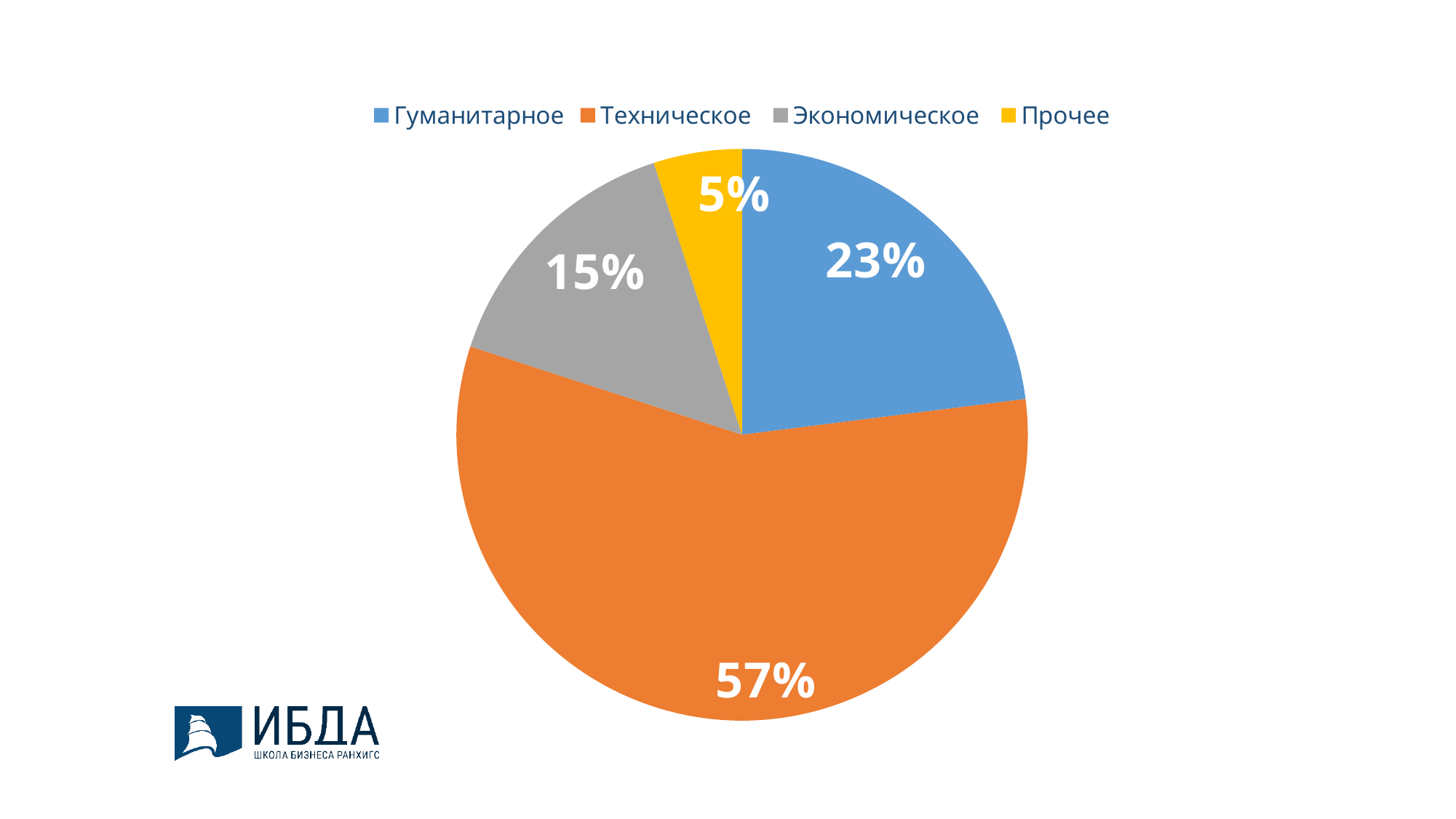
Which category has the smallest slice? Прочее What colour is the slice for Прочее? yellow What is the value for Прочее? 5% What is the value for Экономическое? 15% What is the value for Техническое? 57% Which category has the largest slice? Техническое What is the value for Гуманитарное? 23% How many slices does the pie chart have? 4 What is the difference between the values for Техническое and Гуманитарное? 34% How many entries does the legend list? 4 Which is larger, Гуманитарное or Экономическое? Гуманитарное What kind of chart is shown on the slide? pie chart